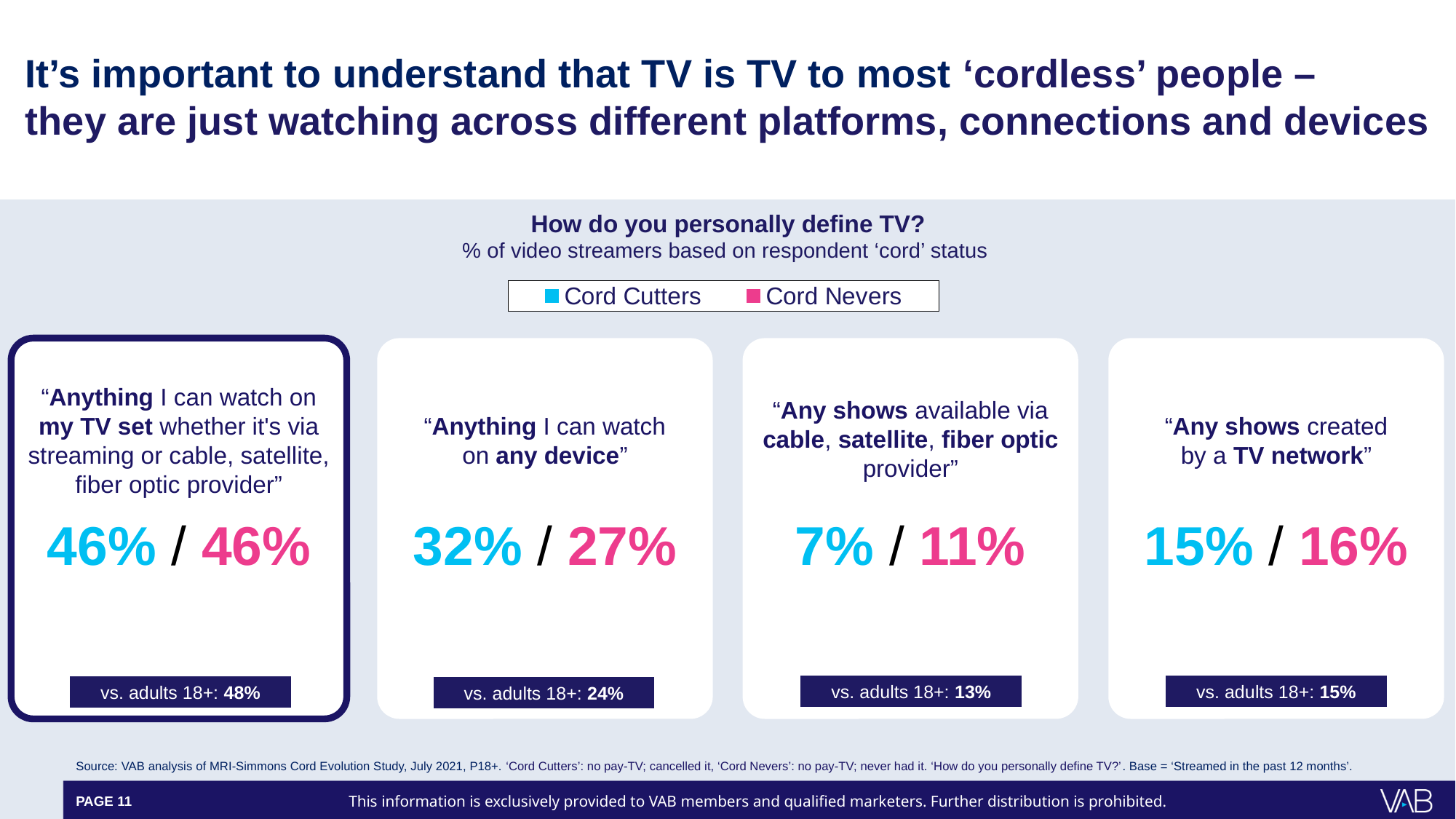
Which colour represents Cord Nevers in the legend? Pink Which definition of TV has the lowest share among Cord Nevers? Any shows available via cable, satellite, fiber optic provider What is the difference between the Cord Cutters and Cord Nevers values for "Anything I can watch on any device"? 5% What is the title of the chart? How do you personally define TV? For "Any shows available via cable, satellite, fiber optic provider", which group has the larger value, Cord Cutters or Cord Nevers? Cord Nevers What is the Cord Nevers value for "Any shows created by a TV network"? 16% How many series does the legend list? 2 What is the "vs. adults 18+" value for "Anything I can watch on my TV set whether it's via streaming or cable, satellite, fiber optic provider"? 48% What percentage of Cord Cutters define TV as "Anything I can watch on any device"? 32% What percentage of Cord Nevers define TV as "Any shows available via cable, satellite, fiber optic provider"? 11% Which definition of TV has the highest share among Cord Cutters? Anything I can watch on my TV set whether it's via streaming or cable, satellite, fiber optic provider How many definitions of TV are shown on the slide? 4